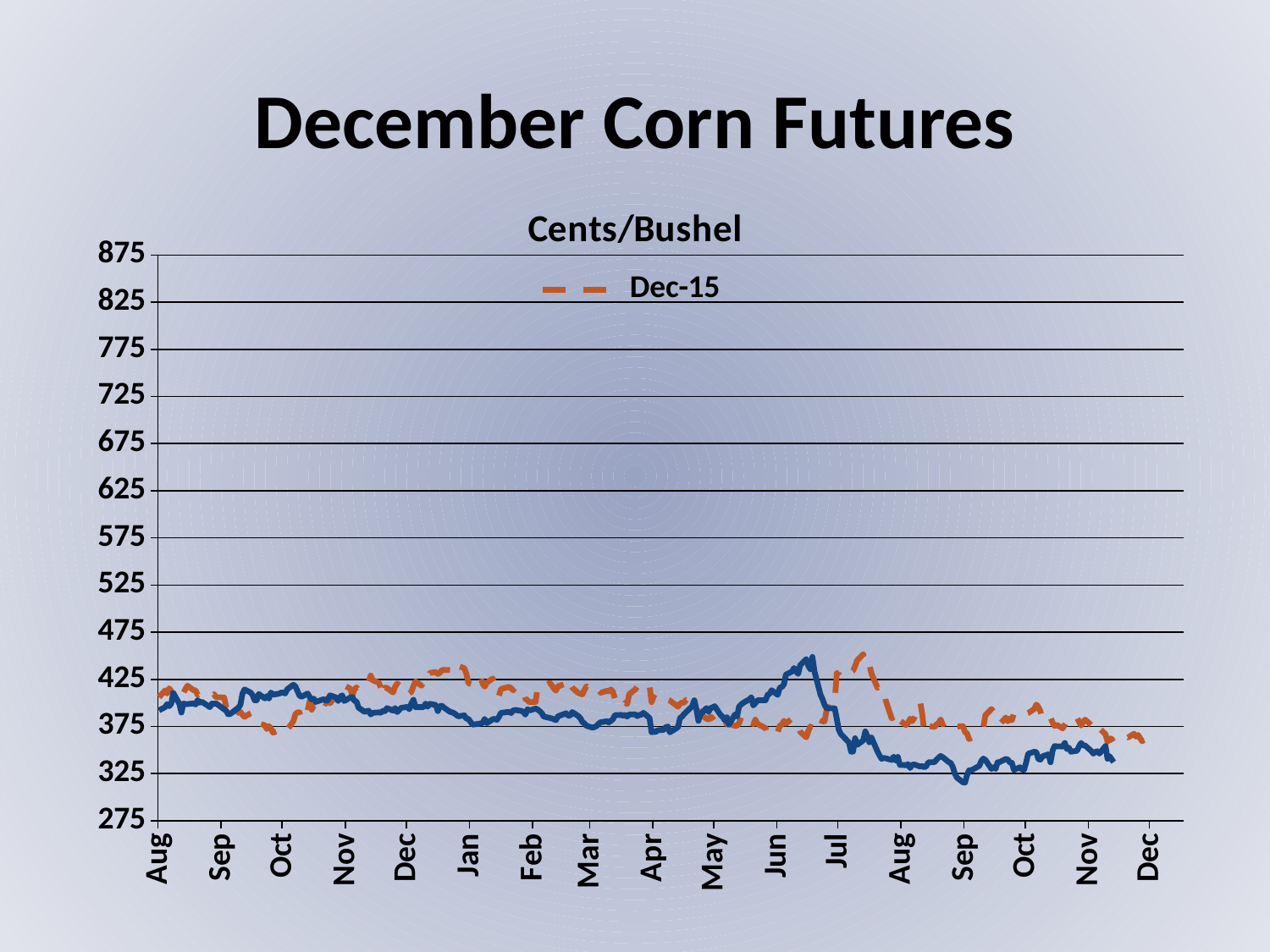
What kind of chart is shown on the slide? line chart What is the title shown above the chart's plot area? Cents/Bushel Does the Dec-15 series rise or fall from July to December? fall Is the value of the Dec-15 series at the final Dec label greater or less than 375? less At the second Oct label, which line is higher: the Dec-15 dashed line or the solid blue line? Dec-15 What is the highest value shown on the y axis? 875 How many month labels are shown along the x axis? 17 Is the peak of the solid blue line in late June greater or less than 425? greater What is the name of the series listed in the legend? Dec-15 Is the lowest value of the solid blue line, around the second Sep label, greater or less than 325? less How many series does the chart's legend list? 1